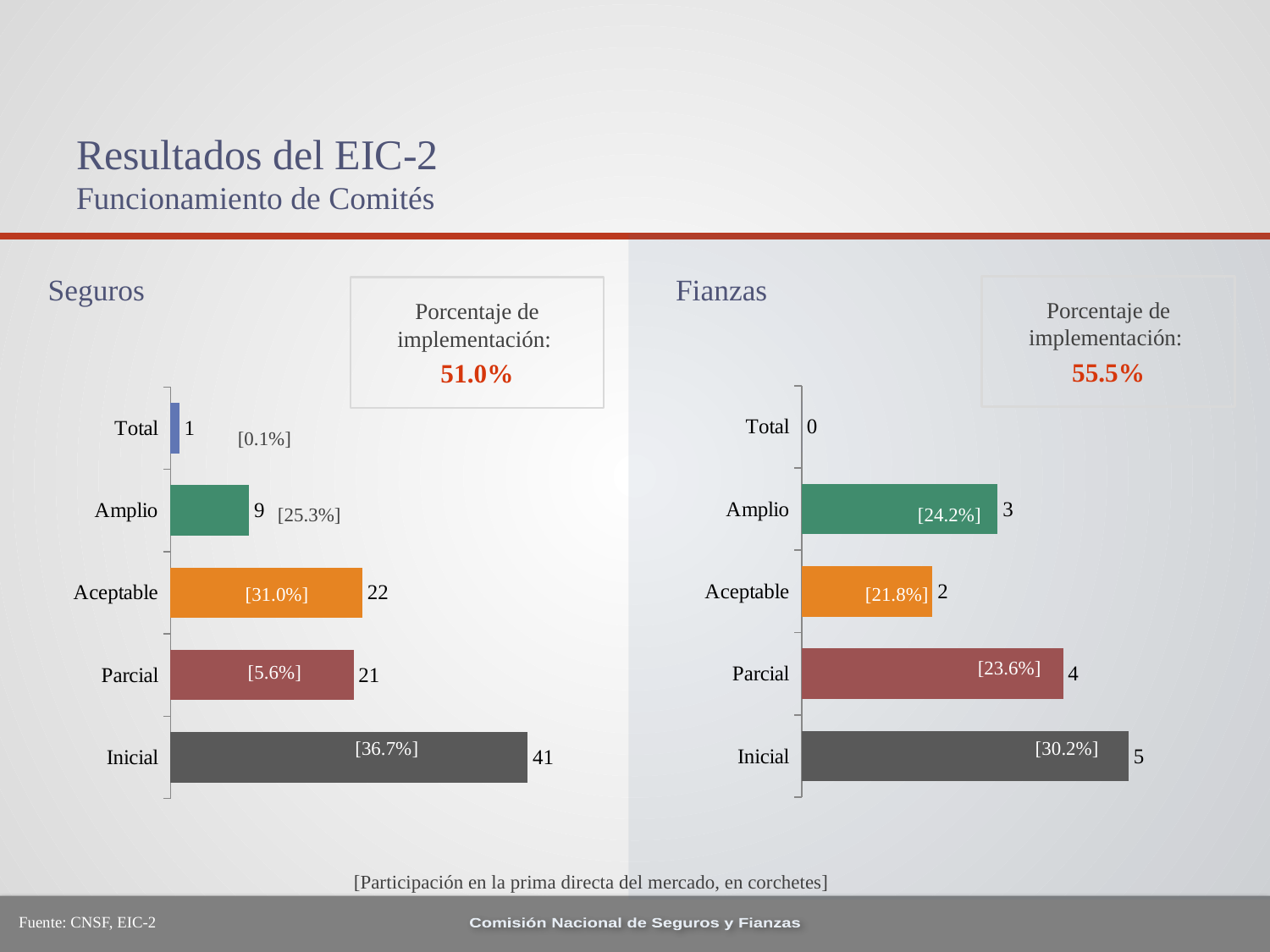
What is the Porcentaje de implementación shown for Fianzas? 55.5% In the Seguros chart, what market share in brackets is shown for Aceptable? [31.0%] In the Fianzas chart, what is the value for Parcial? 4 What is the Porcentaje de implementación shown for Seguros? 51.0% In the Seguros chart, what is the value for Inicial? 41 In the Fianzas chart, which category has the lowest value? Total In the Seguros chart, which category has the highest value? Inicial In the Fianzas chart, which is larger, the value for Inicial or the value for Amplio? Inicial In the Fianzas chart, what market share in brackets is shown for Inicial? [30.2%] What kind of chart is the Fianzas chart? Bar chart How many categories does the Seguros chart show? 5 In the Seguros chart, what is the difference between the values for Aceptable and Parcial? 1